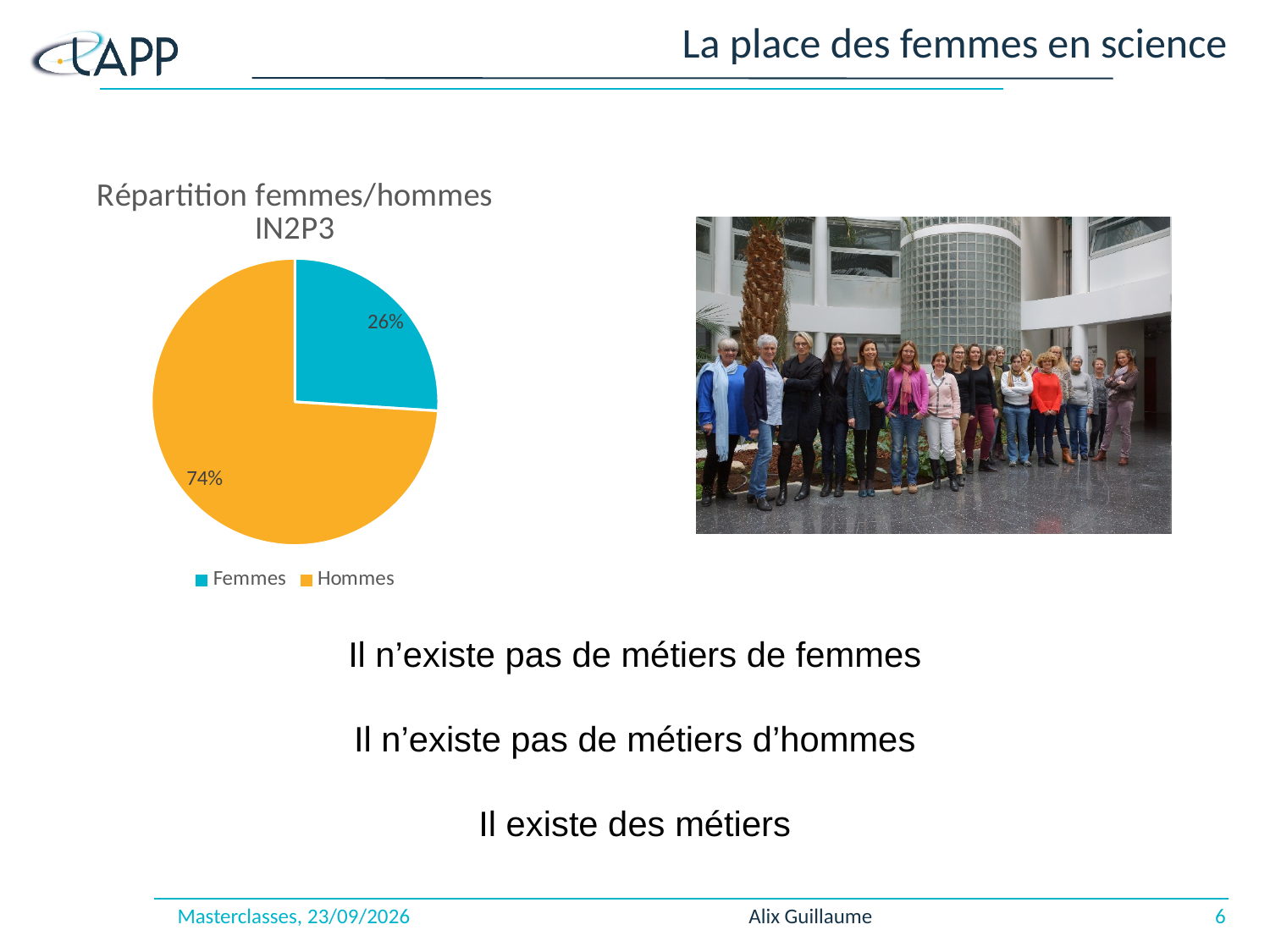
How many entries does the legend list? 2 Which category has the smallest share of the pie? Femmes What percentage of the pie is labelled for Femmes? 26% What is the title of the chart? Répartition femmes/hommes IN2P3 Which share is larger, Femmes or Hommes? Hommes What percentage of the pie is labelled for Hommes? 74% What is the share of the pie for Femmes? 26% How many categories does the pie chart have? 2 Which category has the largest share of the pie? Hommes What is the difference in percentage points between the Hommes and Femmes shares? 48 What colour is the Femmes slice? blue What kind of chart is shown on the slide? pie chart